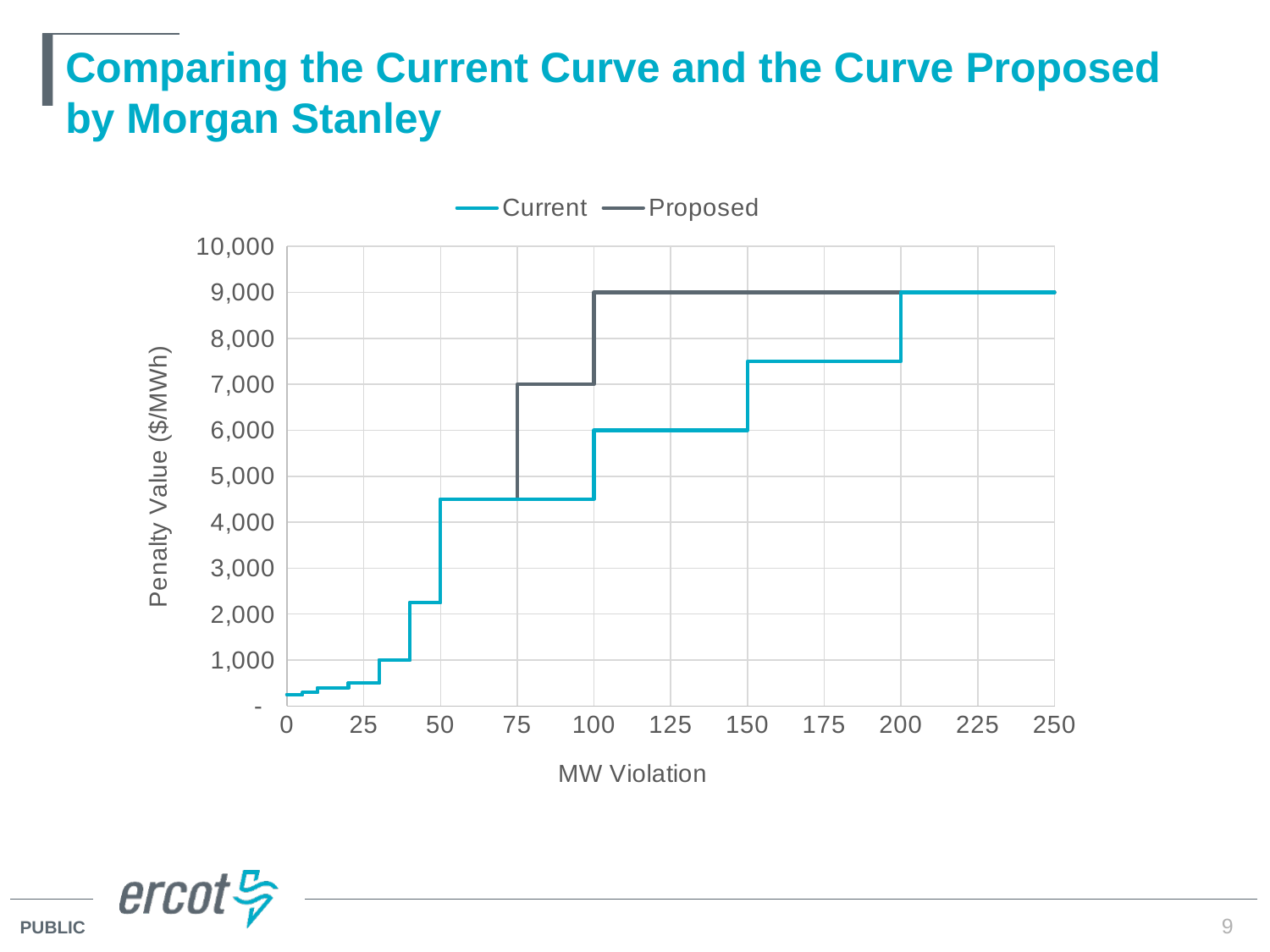
Is the Current penalty value at an MW Violation of 175 greater or less than 7,000? greater What is the Current penalty value at an MW Violation of 225? 9,000 What is the Proposed penalty value at an MW Violation of 150? 9,000 What kind of chart is shown on the slide? Line chart What is the Proposed penalty value at an MW Violation of 90? 7,000 What are the two series named in the legend? Current and Proposed What is the label of the y axis? Penalty Value ($/MWh) What is the Current penalty value at an MW Violation of 125? 6,000 At an MW Violation of 125, which series has the larger penalty value, Current or Proposed? Proposed Does the Current penalty value rise or fall as MW Violation increases? rise How many series does the legend list? 2 Is the Current penalty value at an MW Violation of 60 greater or less than 5,000? less